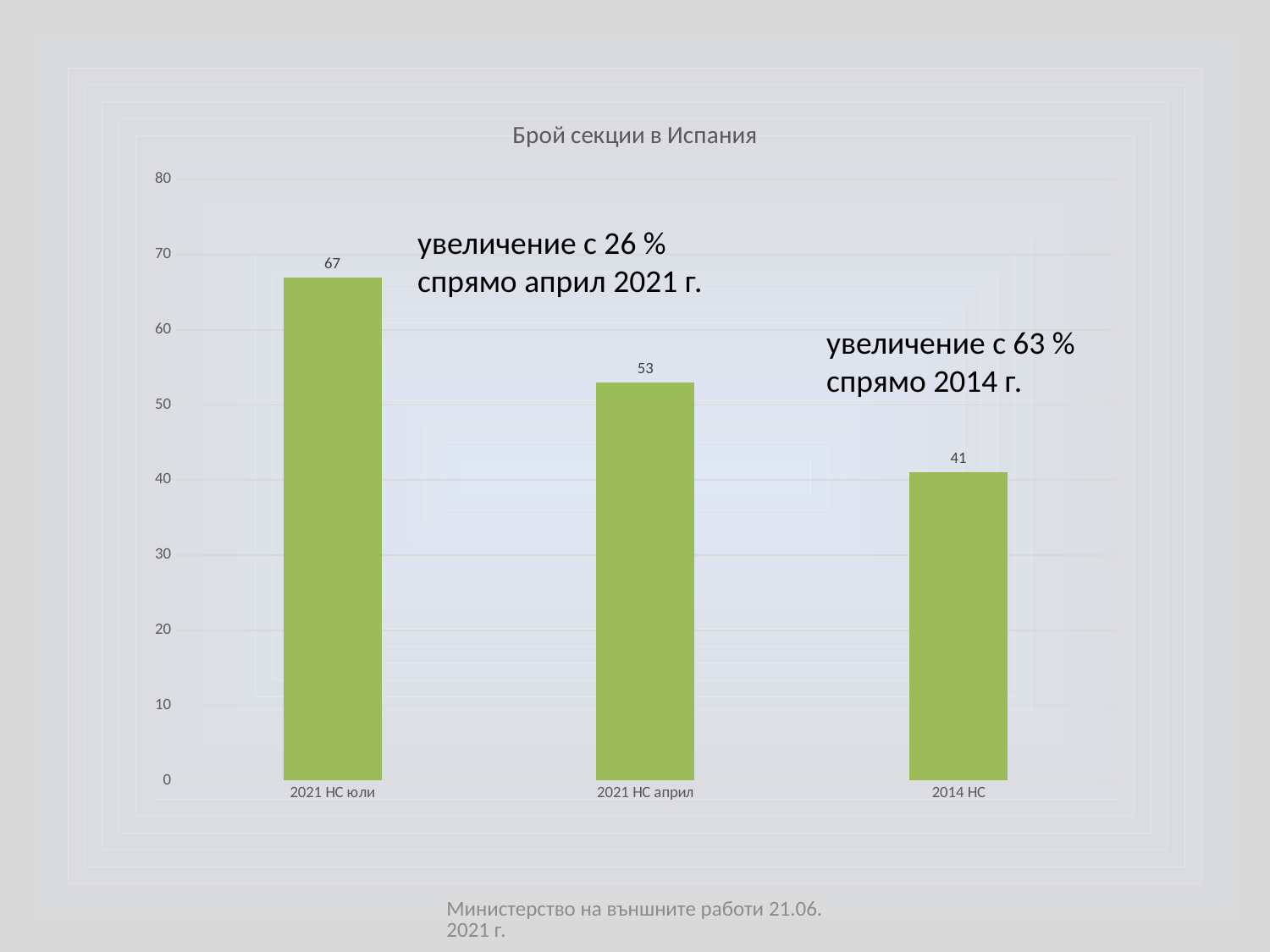
Which category has the highest value? 2021 НС юли What is the value for 2021 НС април? 53 Which is larger, the value for 2021 НС април or the value for 2014 НС? 2021 НС април What is the difference between the values for 2021 НС юли and 2021 НС април? 14 How many categories are shown on the chart? 3 What kind of chart is shown on the slide? bar chart What is the value for 2014 НС? 41 Is the value for 2014 НС greater or less than 50? less Which category has the lowest value? 2014 НС What is the title of the chart? Брой секции в Испания What is the value for 2021 НС юли? 67 What is the difference between the values for 2021 НС април and 2014 НС? 12